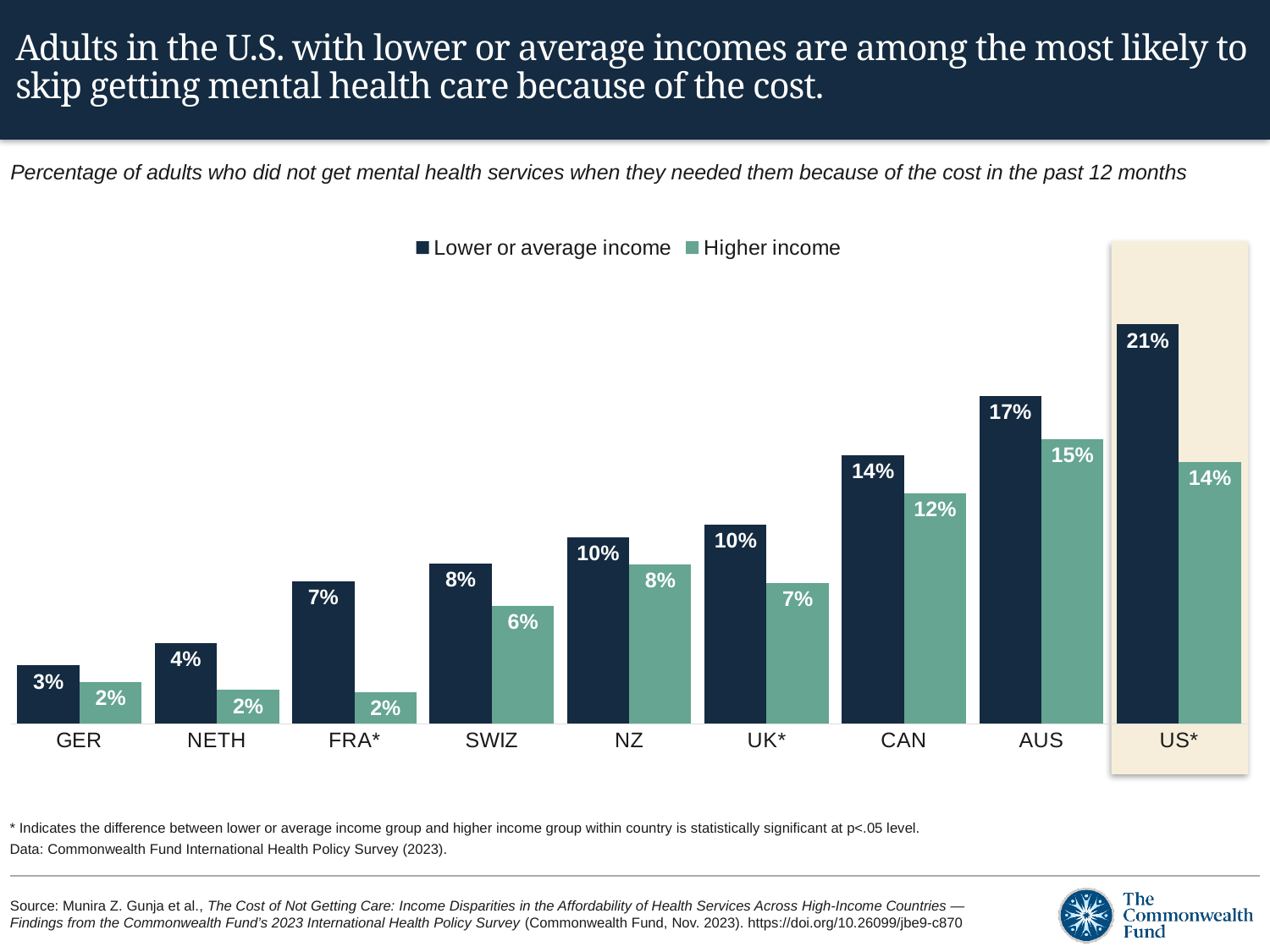
What is the difference between the Lower or average income values for CAN and SWIZ? 6% How many series does the legend list? 2 What is the difference between the Lower or average income and Higher income values for the US*? 7% What kind of chart is shown on the slide? Bar chart What is the value for Higher income in AUS? 15% What is the value for Lower or average income in the US*? 21% Which country has the lowest value for Lower or average income? GER Which country has the highest value for Lower or average income? US* What is the value for Higher income in FRA*? 2% Do the Lower or average income values rise or fall from GER to US* along the x axis? Rise How many countries are shown on the x axis? 9 Which is larger, the Higher income value for CAN or the Higher income value for NZ? CAN